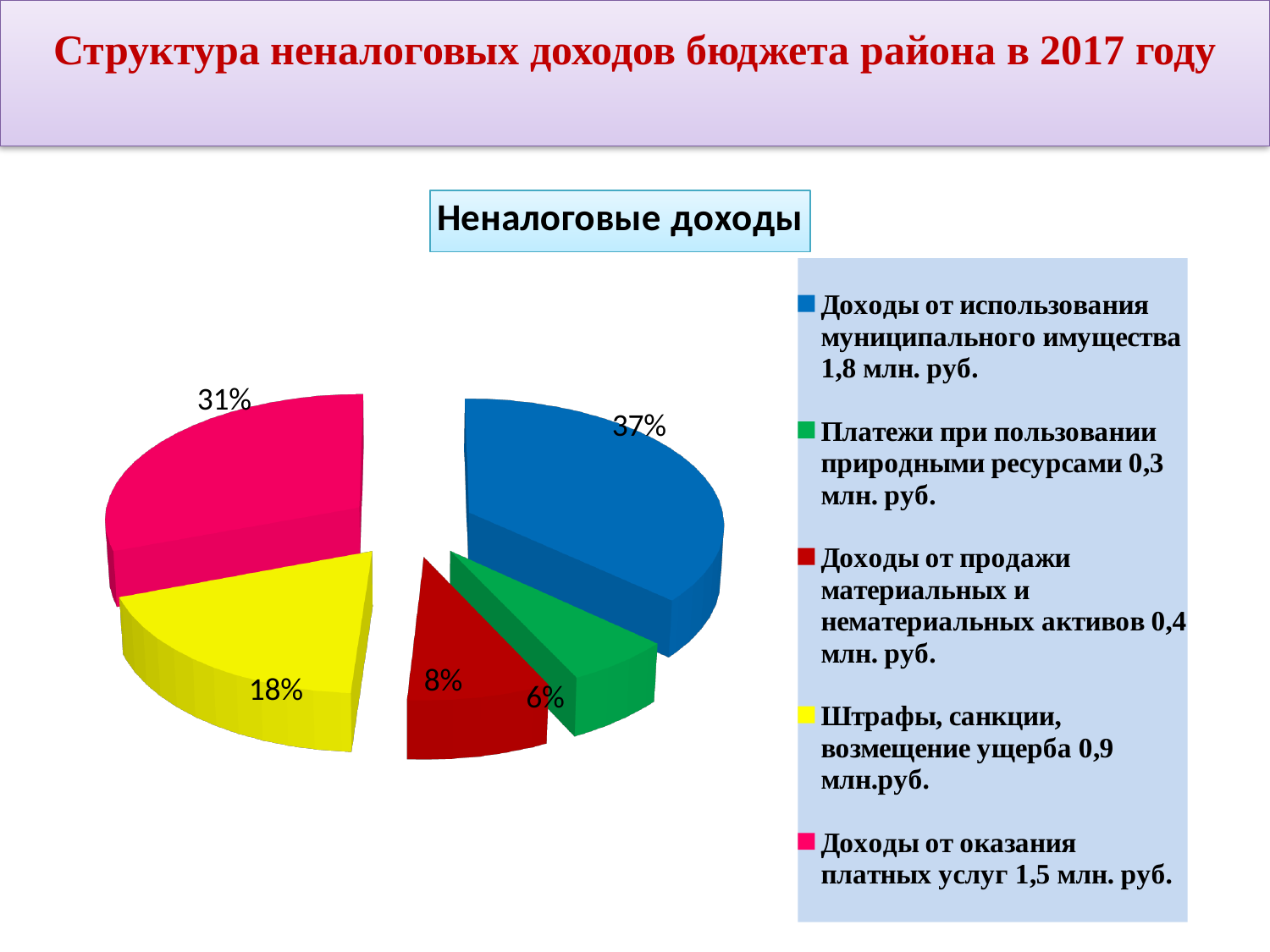
What share of the pie does the slice for "Доходы от продажи материальных и нематериальных активов" have? 8% What share of the pie does the slice for "Доходы от оказания платных услуг" have? 31% What share of the pie does the slice for "Платежи при пользовании природными ресурсами" have? 6% Which category has the smallest slice of the pie? Платежи при пользовании природными ресурсами What colour is the slice for "Доходы от оказания платных услуг"? Pink How many slices does the pie chart have? 5 Which slice is larger: "Штрафы, санкции, возмещение ущерба" or "Доходы от продажи материальных и нематериальных активов"? Штрафы, санкции, возмещение ущерба What kind of chart is shown on the slide? Pie chart Which category has the largest slice of the pie? Доходы от использования муниципального имущества What is the difference in percentage points between the slices for "Доходы от использования муниципального имущества" and "Доходы от оказания платных услуг"? 6 percentage points